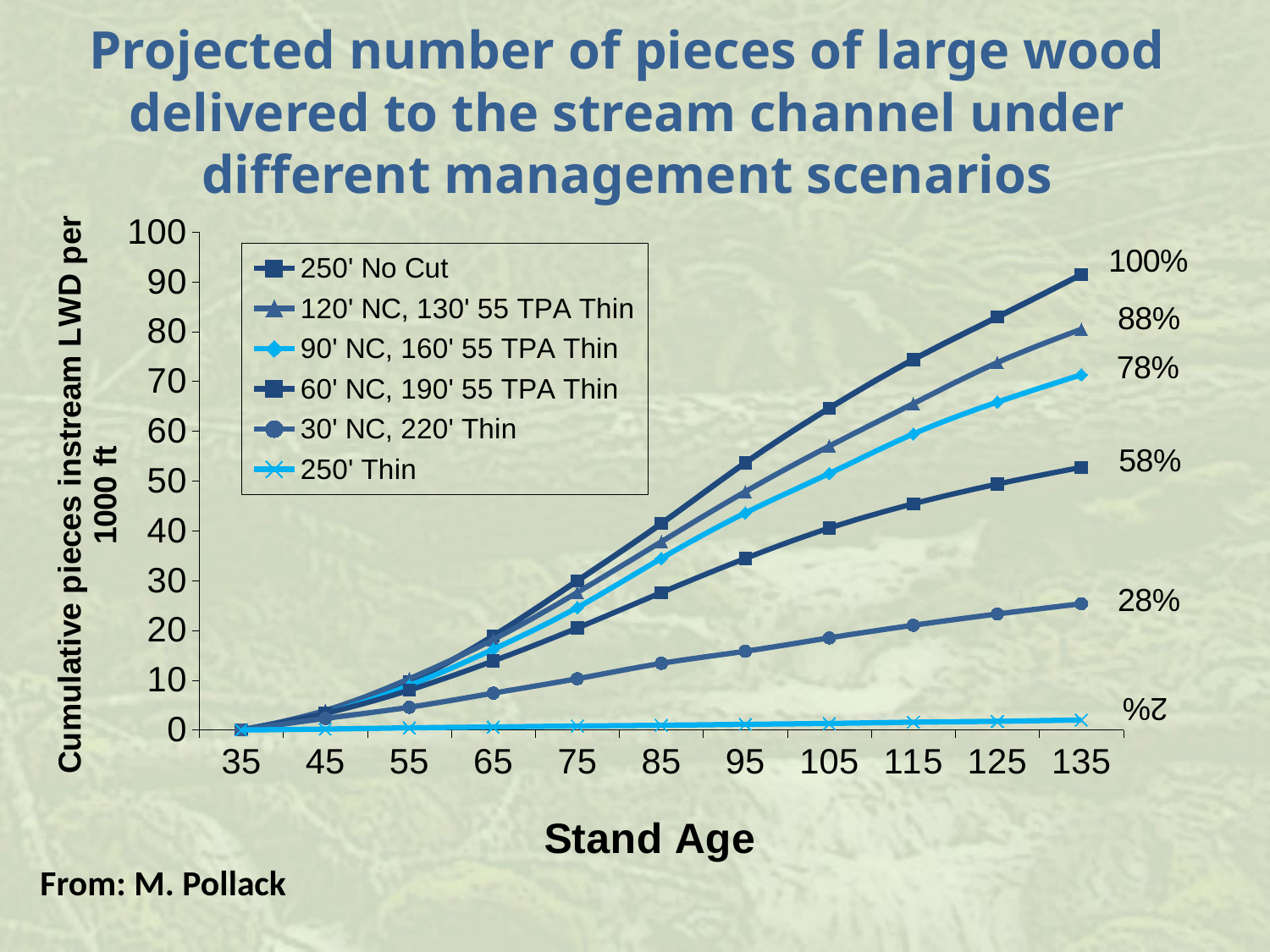
How many series does the legend list? 6 Is the value for 30' NC, 220' Thin at stand age 135 greater or less than 30? less Which management scenario has the lowest cumulative pieces of instream LWD at stand age 135? 250' Thin Is the value for 90' NC, 160' 55 TPA Thin at stand age 135 greater or less than 60? greater At stand age 135, which is larger: the value for 250' No Cut or the value for 250' Thin? 250' No Cut Which management scenario has the highest cumulative pieces of instream LWD at stand age 135? 250' No Cut What is the label on the x axis of the chart? Stand Age Is the value for 250' No Cut at stand age 135 greater or less than 80? greater How many stand age values are marked along the x axis? 11 What kind of chart is shown on the slide? line chart Do the values for 250' No Cut rise or fall as stand age increases? rise